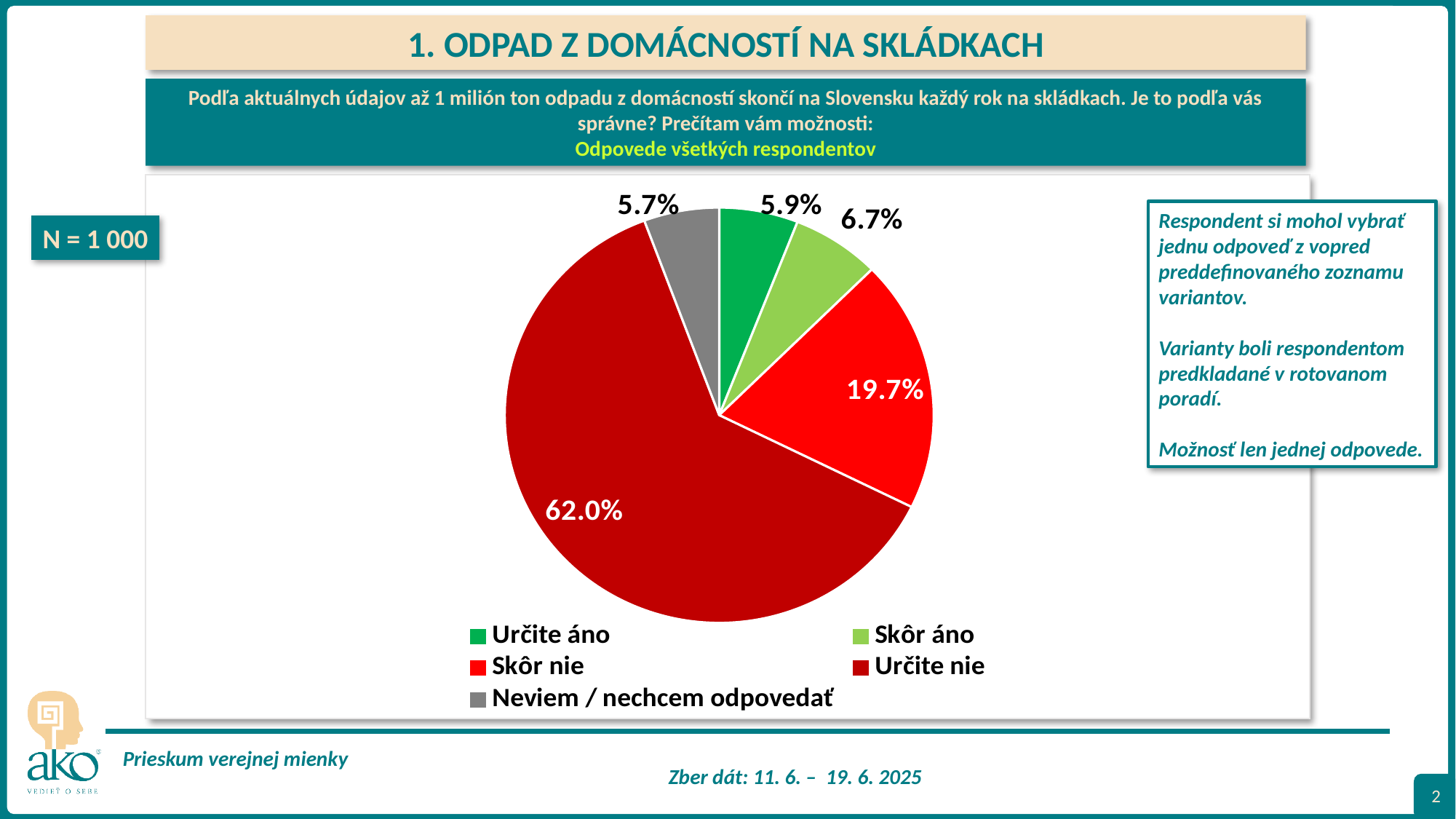
What percentage of respondents answered "Skôr nie"? 19.7% Which answer has the largest share of the pie? Určite nie How many entries does the legend list? 5 What percentage of respondents answered "Neviem / nechcem odpovedať"? 5.7% What type of chart is shown on the slide? pie chart What is the difference in percentage points between "Určite nie" and "Skôr nie"? 42.3 What percentage of respondents answered "Určite nie"? 62.0% What colour is the "Neviem / nechcem odpovedať" slice? grey Which is larger, the share for "Skôr nie" or the share for "Skôr áno"? Skôr nie What percentage of respondents answered "Určite áno"? 5.9% What percentage of respondents answered "Skôr áno"? 6.7% How many slices does the pie chart have? 5